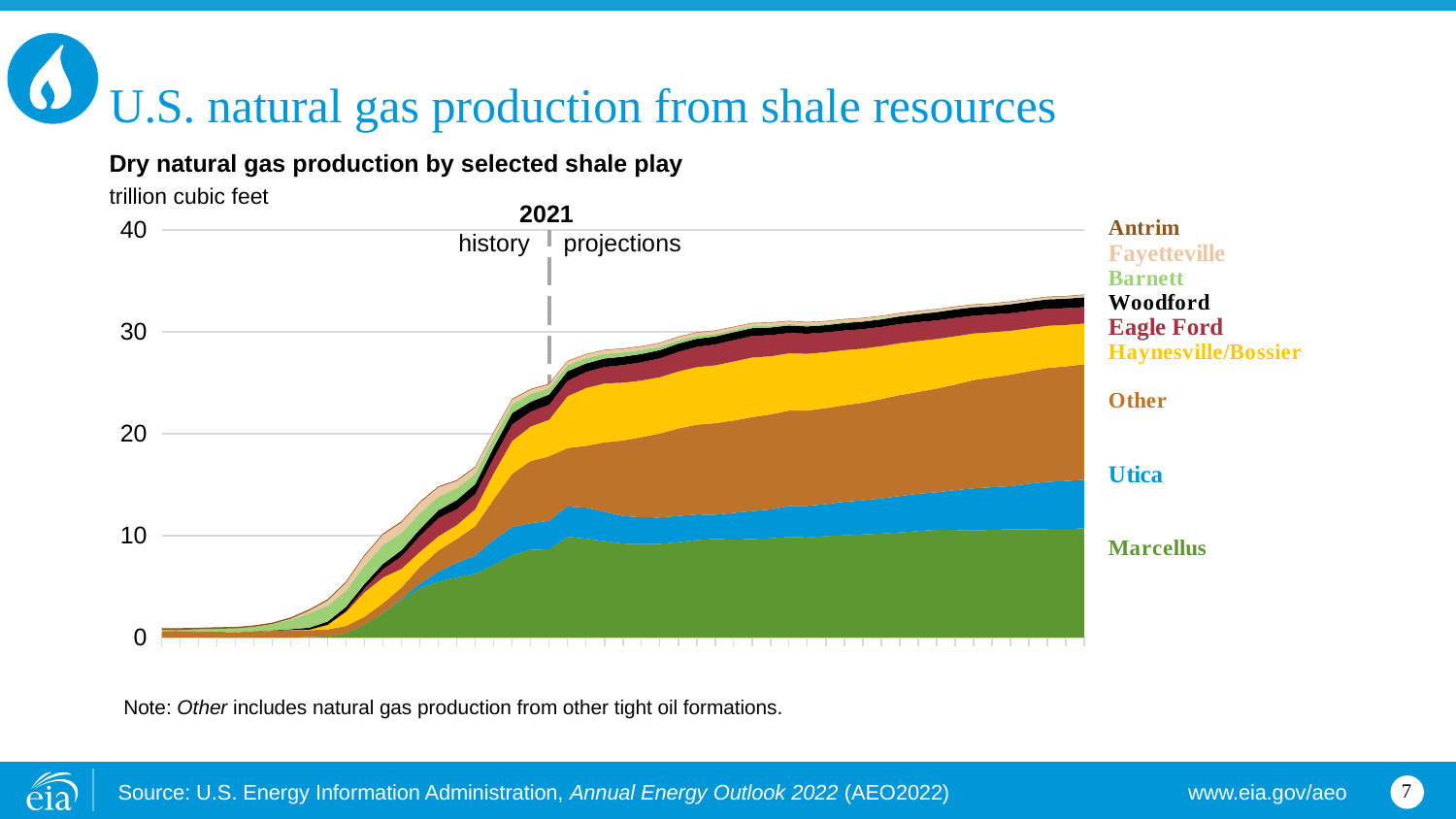
What kind of chart is shown on the slide? stacked area chart Is Marcellus production at the end of the projection period greater or less than 20? less What unit is the y axis measured in? trillion cubic feet Is total dry natural gas production from shale in 2021 greater or less than 20? greater At the end of the projection period, which is larger: production from Other or from Haynesville/Bossier? Other What is the highest value shown on the y axis? 40 At the end of the projection period, which is larger: production from Marcellus or from Utica? Marcellus How many shale plays (series) does the legend list? 9 Does total shale gas production rise or fall over the period shown? rise Is total dry natural gas production from shale at the end of the projection period greater or less than 30? greater What is the title of the chart? Dry natural gas production by selected shale play